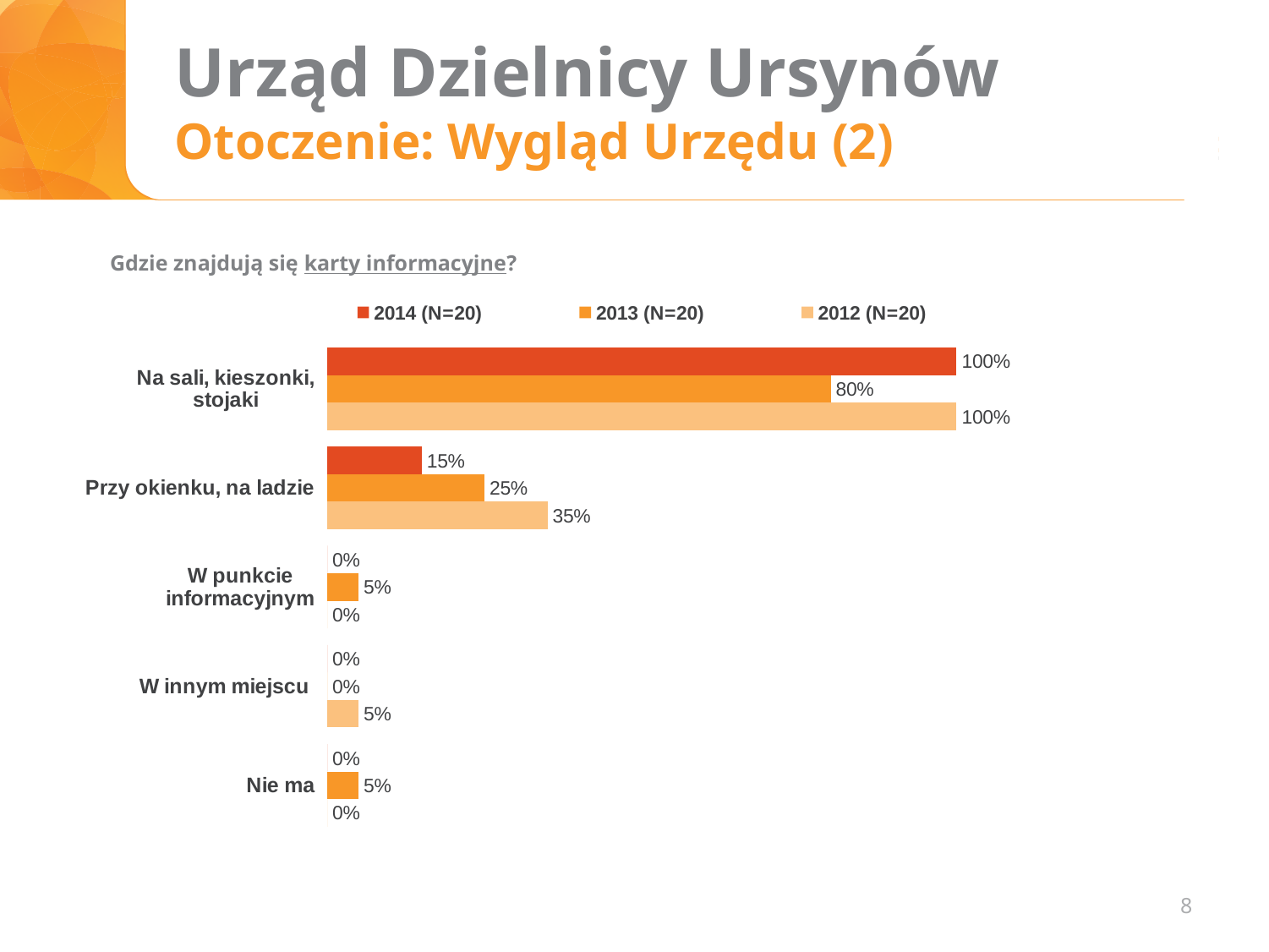
What is the value for 'W punkcie informacyjnym' in the 2013 (N=20) series? 5% What is the difference between the 2013 (N=20) and 2014 (N=20) values for 'Przy okienku, na ladzie'? 10% Which category has the highest value in the 2014 (N=20) series? Na sali, kieszonki, stojaki What is the value for 'Nie ma' in the 2014 (N=20) series? 0% What is the value for 'Na sali, kieszonki, stojaki' in the 2013 (N=20) series? 80% For 'Na sali, kieszonki, stojaki', which is larger: the 2014 (N=20) value or the 2013 (N=20) value? 2014 (N=20) What kind of chart is shown on the slide? Bar chart How many categories are shown on the chart? 5 How many series does the legend list? 3 What is the value for 'Przy okienku, na ladzie' in the 2012 (N=20) series? 35% What question does the chart answer, as stated above it? Gdzie znajdują się karty informacyjne? What is the difference between the 2012 (N=20) and 2014 (N=20) values for 'Przy okienku, na ladzie'? 20%